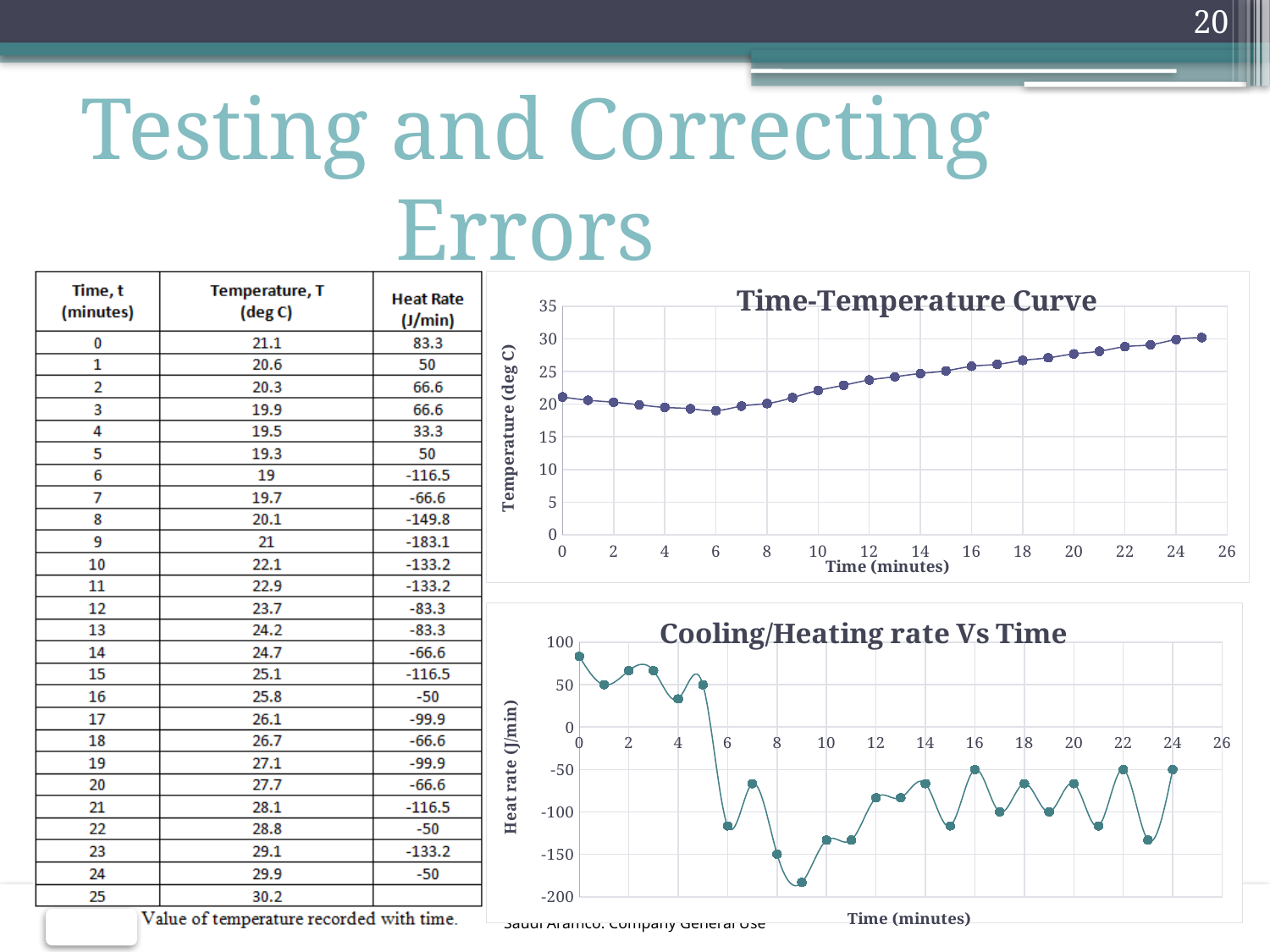
In the Cooling/Heating rate Vs Time chart, is the heat rate at 9 minutes greater or less than -150? less In the Time-Temperature Curve, does the temperature rise or fall between 6 and 25 minutes? rise In the Time-Temperature Curve, at which time (minutes) is the temperature highest? 25 What is the y-axis title of the Cooling/Heating rate Vs Time chart? Heat rate (J/min) In the Cooling/Heating rate Vs Time chart, at which time (minutes) is the heat rate lowest? 9 What kind of chart is the Time-Temperature Curve? line chart How many data points are plotted in the Time-Temperature Curve? 26 In the Time-Temperature Curve, is the temperature at 12 minutes greater or less than 20? greater What kind of chart is the Cooling/Heating rate Vs Time chart? line chart In the Time-Temperature Curve, is the temperature at 3 minutes greater or less than 25? less In the Cooling/Heating rate Vs Time chart, at which time (minutes) is the heat rate highest? 0 In the Time-Temperature Curve, at which time (minutes) is the temperature lowest? 6